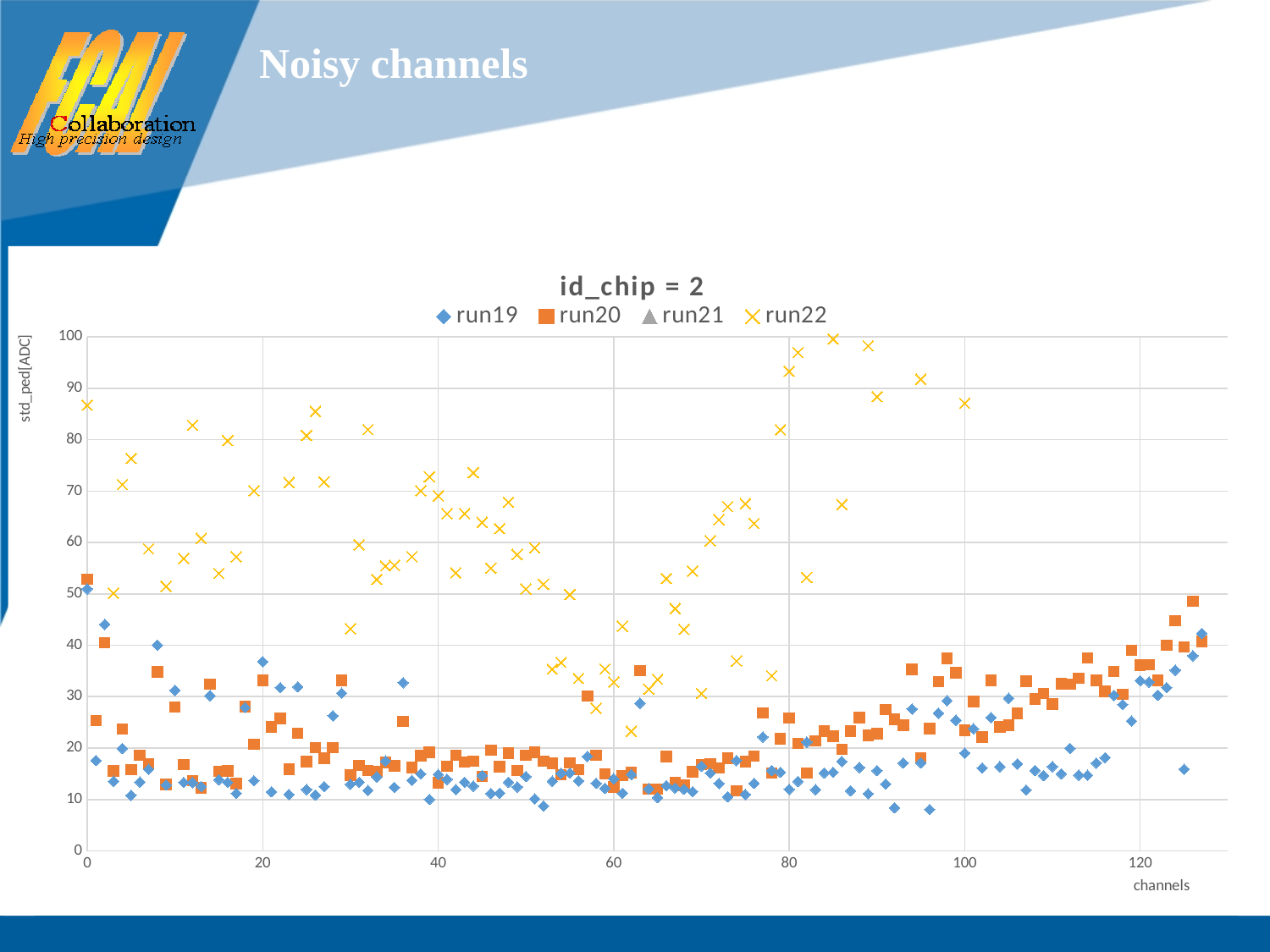
What kind of chart is shown on the slide? scatter chart Which series reaches the highest values on the chart? run22 Is the value for run22 at channel 100 greater or less than 80? greater How many series does the legend list? 4 Is the value for run20 at channel 0 greater or less than 40? greater Is the value for run19 at channel 96 greater or less than 10? less Which series has the larger value at channel 0, run19 or run22? run22 Do the run20 values rise or fall between channel 100 and channel 127? rise What is the title of the chart? id_chip = 2 What is the label of the x axis? channels